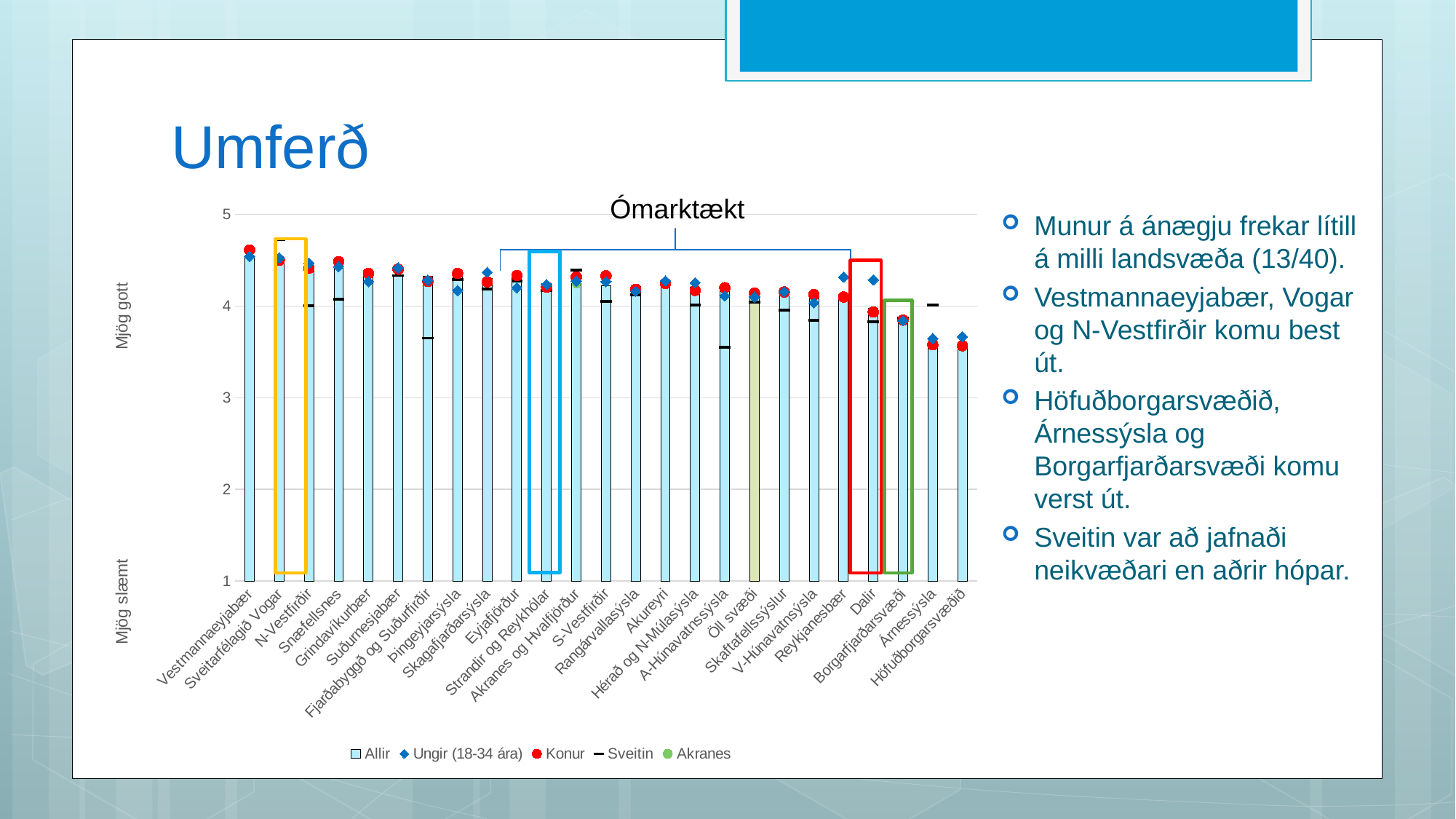
Which has the larger 'Allir' value, Vestmannaeyjabær or Höfuðborgarsvæðið? Vestmannaeyjabær Which category has the highest 'Allir' bar in the chart? Vestmannaeyjabær How many series does the chart legend list? 5 What kind of chart is shown on the slide? bar chart How many categories (regions) are plotted along the x axis of the chart? 25 Which series in the chart is shown as bars? Allir What label is written above the bracket spanning the middle group of bars in the chart? Ómarktækt Do the 'Allir' bar values generally rise or fall from left to right along the x axis? fall Is the 'Allir' value for Snæfellsnes greater or less than 4? greater Is the 'Allir' value for Vestmannaeyjabær greater or less than 4? greater Is the 'Allir' value for Höfuðborgarsvæðið greater or less than 4? less